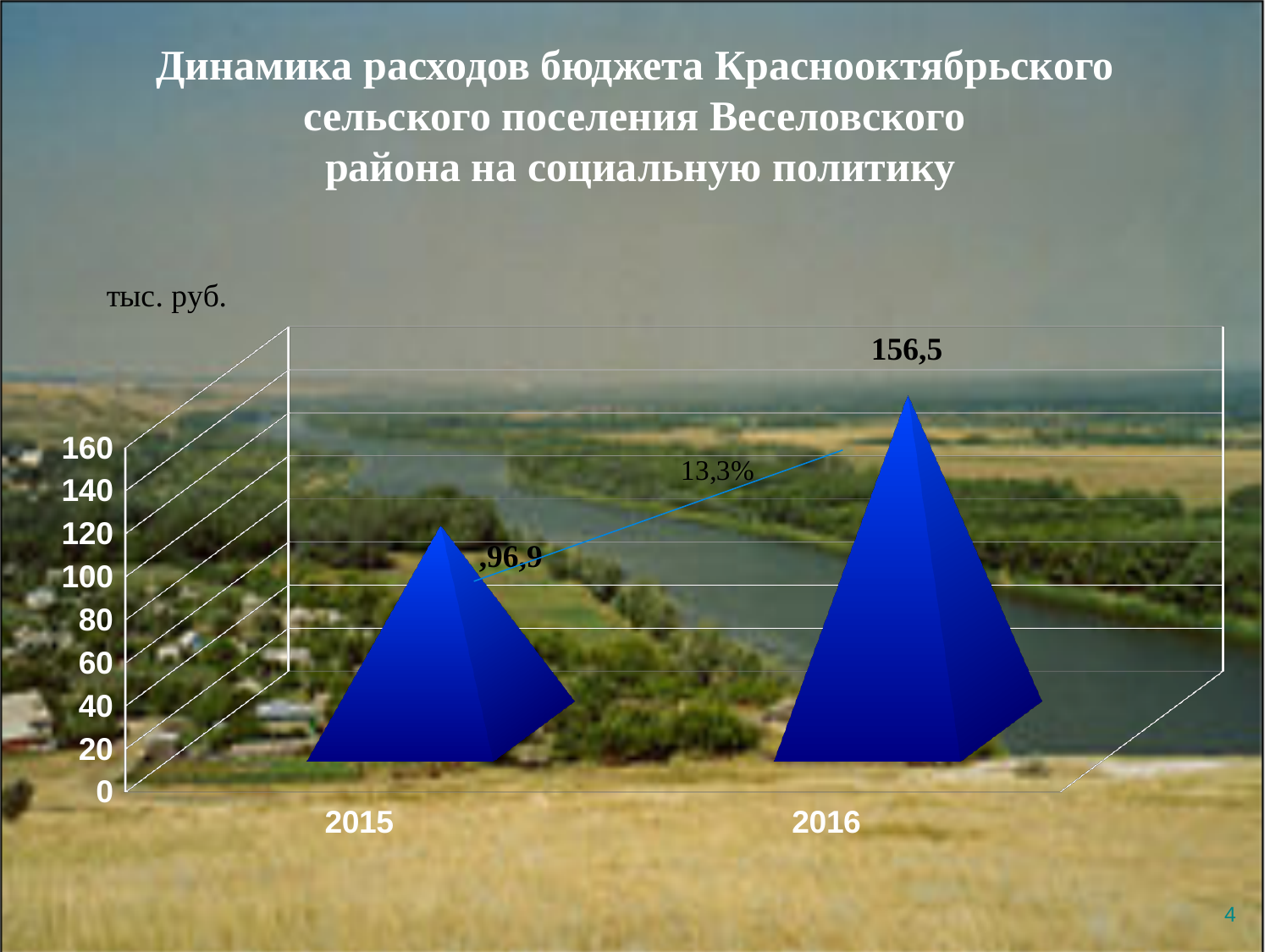
Do the values rise or fall from 2015 to 2016? rise What is the value for 2015? 96,9 Which year has the lower value? 2015 By how much does the value for 2016 exceed the value for 2015? 59,6 What is the value for 2016? 156,5 How many years are shown on the chart? 2 Is the value for 2015 greater or less than 100? less Is the value for 2016 larger or smaller than the value for 2015? larger What unit of measurement is indicated above the chart? тыс. руб. Is the value for 2016 greater or less than 140? greater Which year has the higher value? 2016 What kind of chart is shown on the slide? bar chart